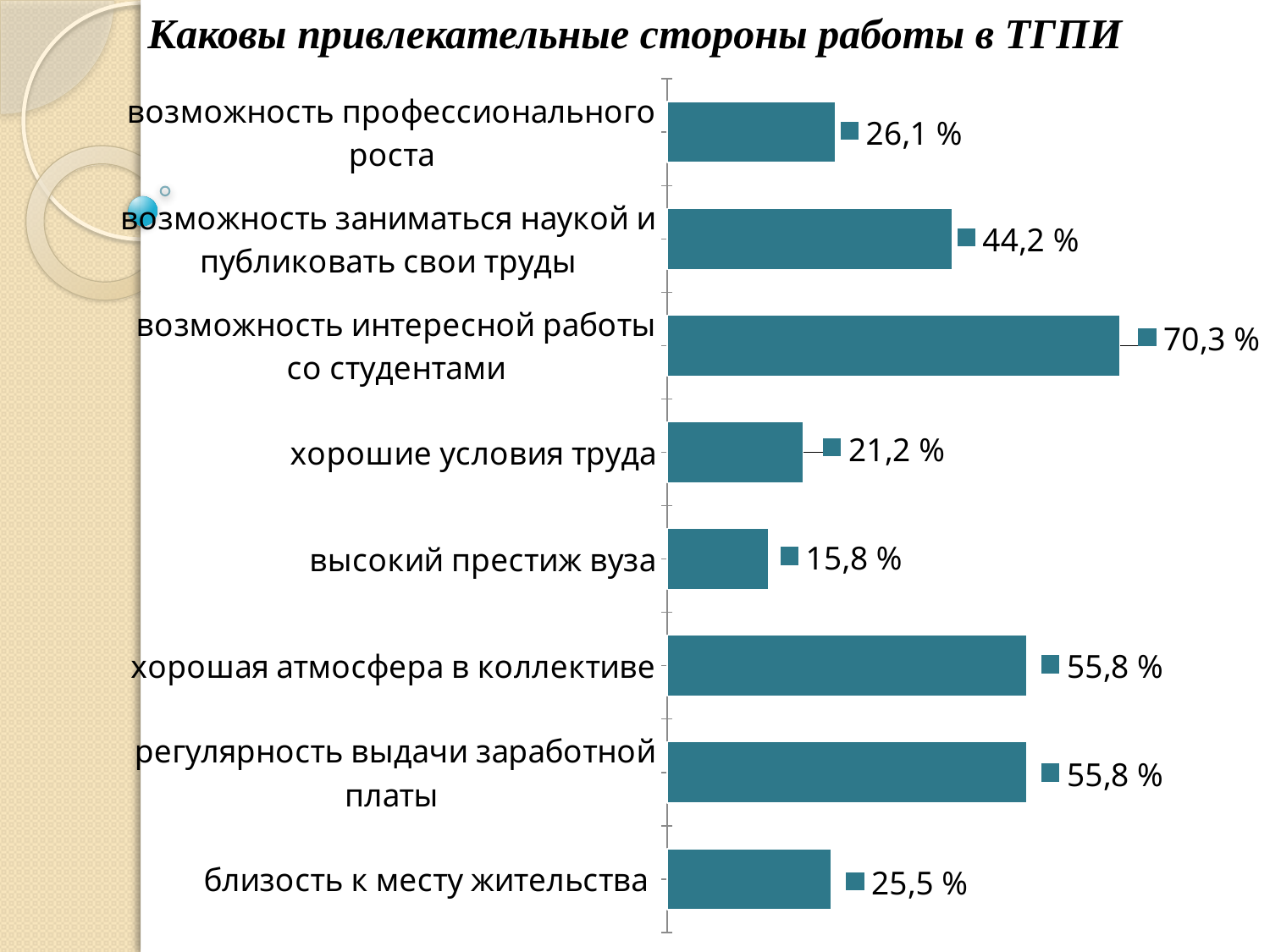
What is the difference between the values for «возможность интересной работы со студентами» and «хорошая атмосфера в коллективе»? 14,5 % What is the value for «высокий престиж вуза»? 15,8 % What is the value for «близость к месту жительства»? 25,5 % What is the difference between the values for «возможность профессионального роста» and «хорошие условия труда»? 4,9 % Which category has the highest value? возможность интересной работы со студентами What is the value for «возможность интересной работы со студентами»? 70,3 % How many categories are shown in the chart? 8 What is the value for «возможность заниматься наукой и публиковать свои труды»? 44,2 % Which is larger: the value for «возможность заниматься наукой и публиковать свои труды» or the value for «возможность профессионального роста»? возможность заниматься наукой и публиковать свои труды Which category has the lowest value? высокий престиж вуза What kind of chart is shown on the slide? bar chart What is the title of the slide? Каковы привлекательные стороны работы в ТГПИ